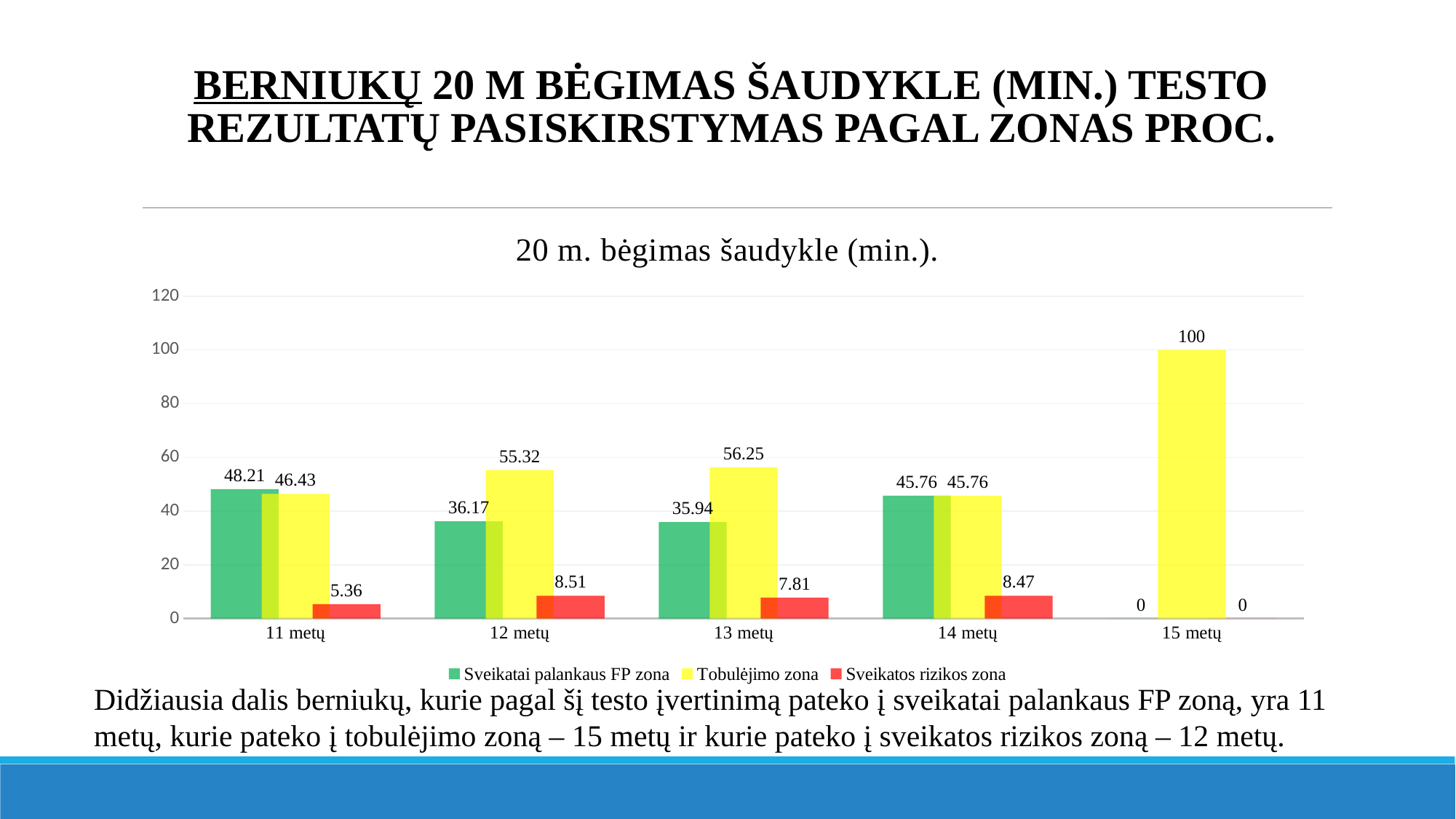
What is the value of Tobulėjimo zona for 15 metų? 100 How many age groups are shown on the x axis? 5 Which age group has the highest value for Sveikatos rizikos zona? 12 metų What is the title of the chart? 20 m. bėgimas šaudykle (min.). What is the value of Tobulėjimo zona for 12 metų? 55.32 What kind of chart is shown on the slide? Bar chart What is the value of Sveikatai palankaus FP zona for 11 metų? 48.21 Which age group has the lowest value for Sveikatai palankaus FP zona? 15 metų Which is larger for 11 metų: Sveikatai palankaus FP zona or Tobulėjimo zona? Sveikatai palankaus FP zona What is the difference between the Tobulėjimo zona and Sveikatai palankaus FP zona values for 13 metų? 20.31 How many series does the legend list? 3 What is the value of Sveikatos rizikos zona for 13 metų? 7.81